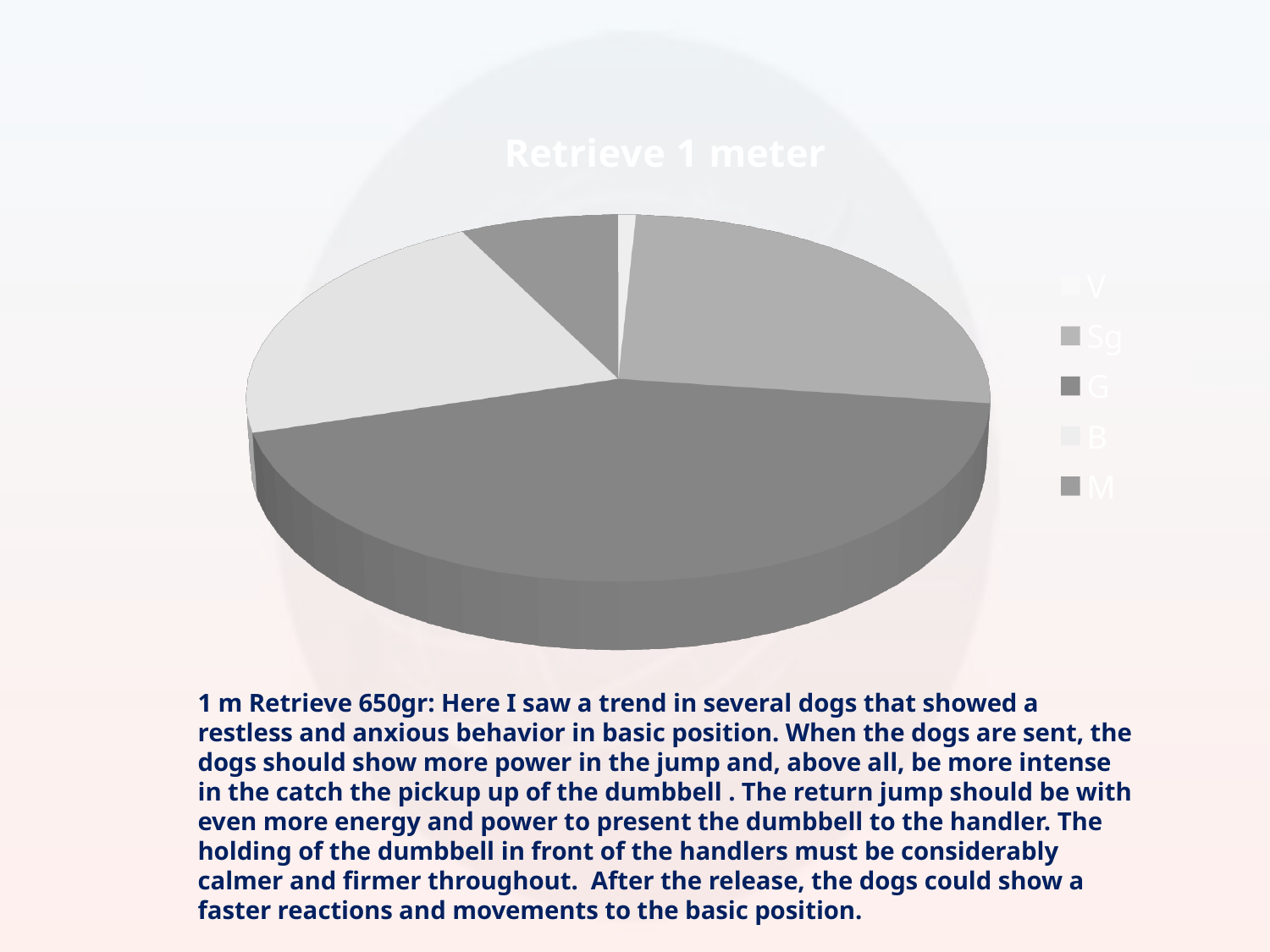
Which category has the largest slice of the pie? G How many slices does the pie chart have? 5 What are the legend entries of the chart, in order? V, Sg, G, B, M Which slice is larger, G or Sg? G How many entries does the chart's legend list? 5 Which slice is larger, Sg or M? Sg What kind of chart is shown on the slide? pie chart What is the title of the chart? Retrieve 1 meter Which slice is larger, M or V? M Which category has the smallest slice of the pie? V